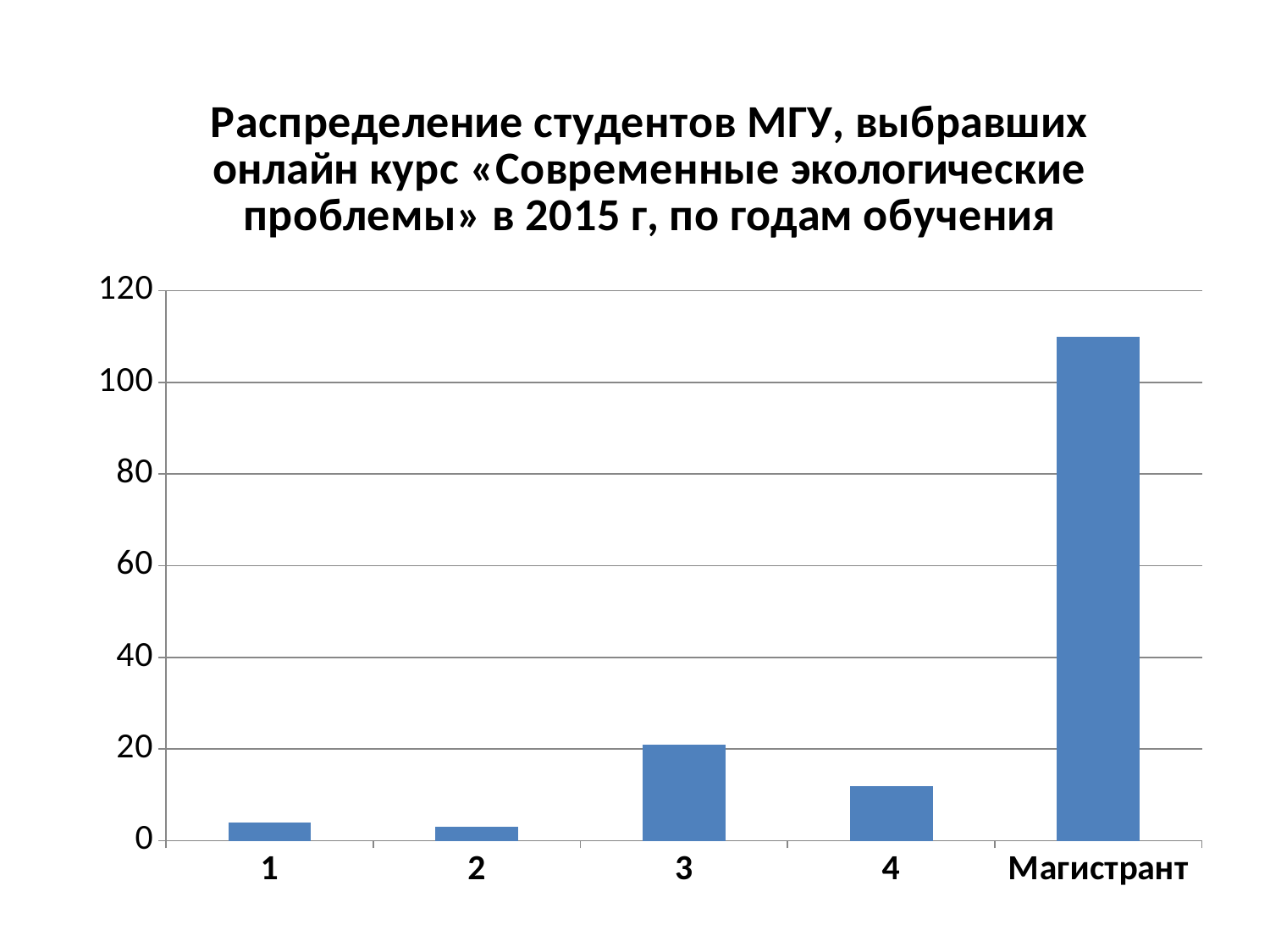
Is the value for category 4 greater or less than 20? less How many categories are shown on the x axis of the chart? 5 Which is larger, the value for category 3 or the value for category 4? category 3 Which is larger, the value for category 4 or the value for category 2? category 4 Is the value for Магистрант greater or less than 120? less What colour are the bars in the chart? blue What kind of chart is shown on the slide? bar chart Which category has the highest value in the chart? Магистрант Is the value for category 3 greater or less than 40? less What is the title of the chart? Распределение студентов МГУ, выбравших онлайн курс «Современные экологические проблемы» в 2015 г, по годам обучения